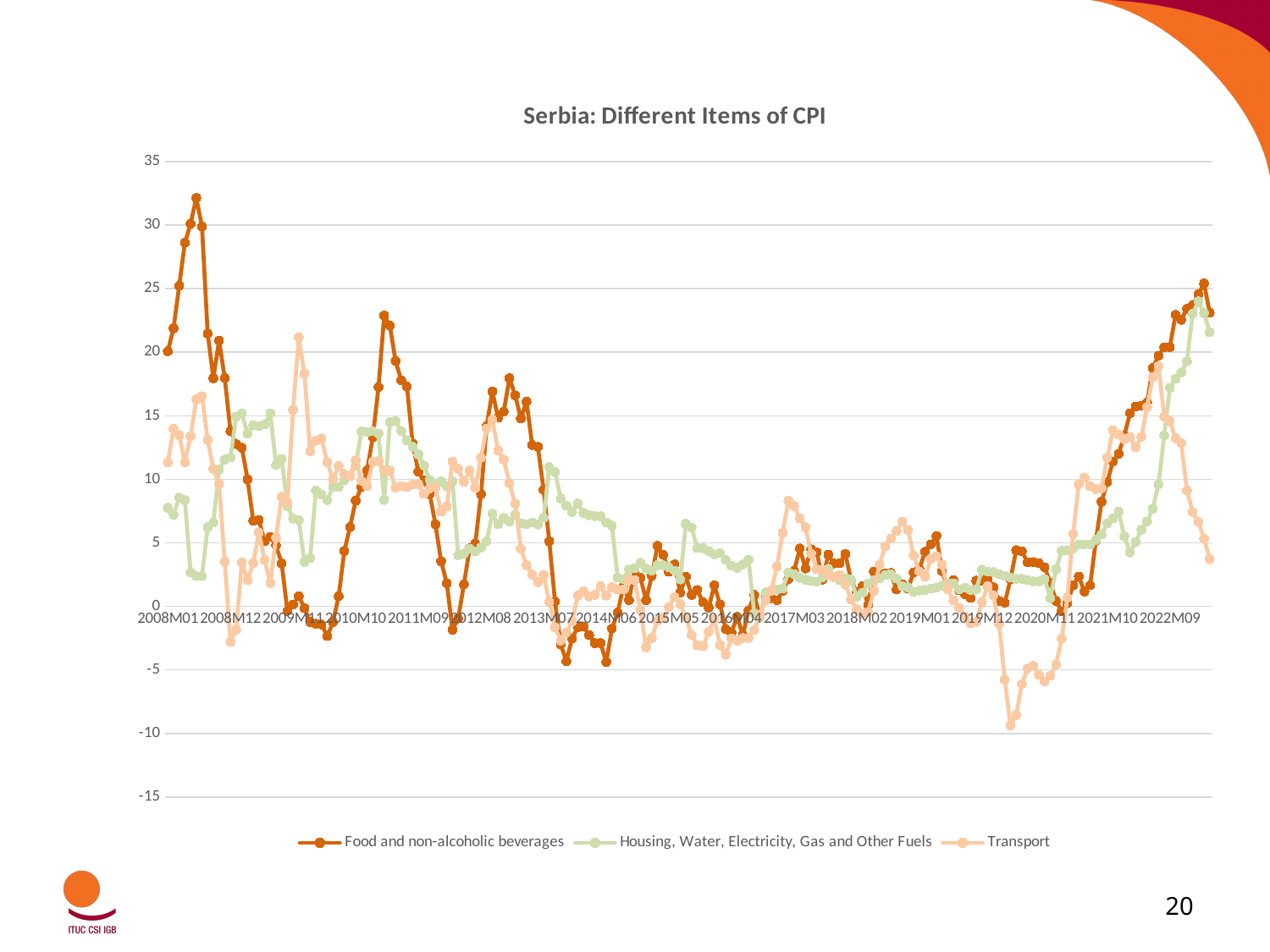
Is the value for Food and non-alcoholic beverages at 2008M12 greater or less than 10? greater Which series reaches the lowest value anywhere on the chart? Transport What kind of chart is shown on the slide? line chart Is the lowest value of Transport, reached around 2020, greater or less than -5? less What is the title of the chart? Serbia: Different Items of CPI Which series reaches the highest value anywhere on the chart? Food and non-alcoholic beverages Is the value for Housing, Water, Electricity, Gas and Other Fuels at its 2022 peak greater or less than 20? greater What is the highest value shown on the vertical axis? 35 Which series is drawn in the dark orange line? Food and non-alcoholic beverages Does the Food and non-alcoholic beverages series rise or fall between 2020M11 and 2022M09? rise How many series does the legend list? 3